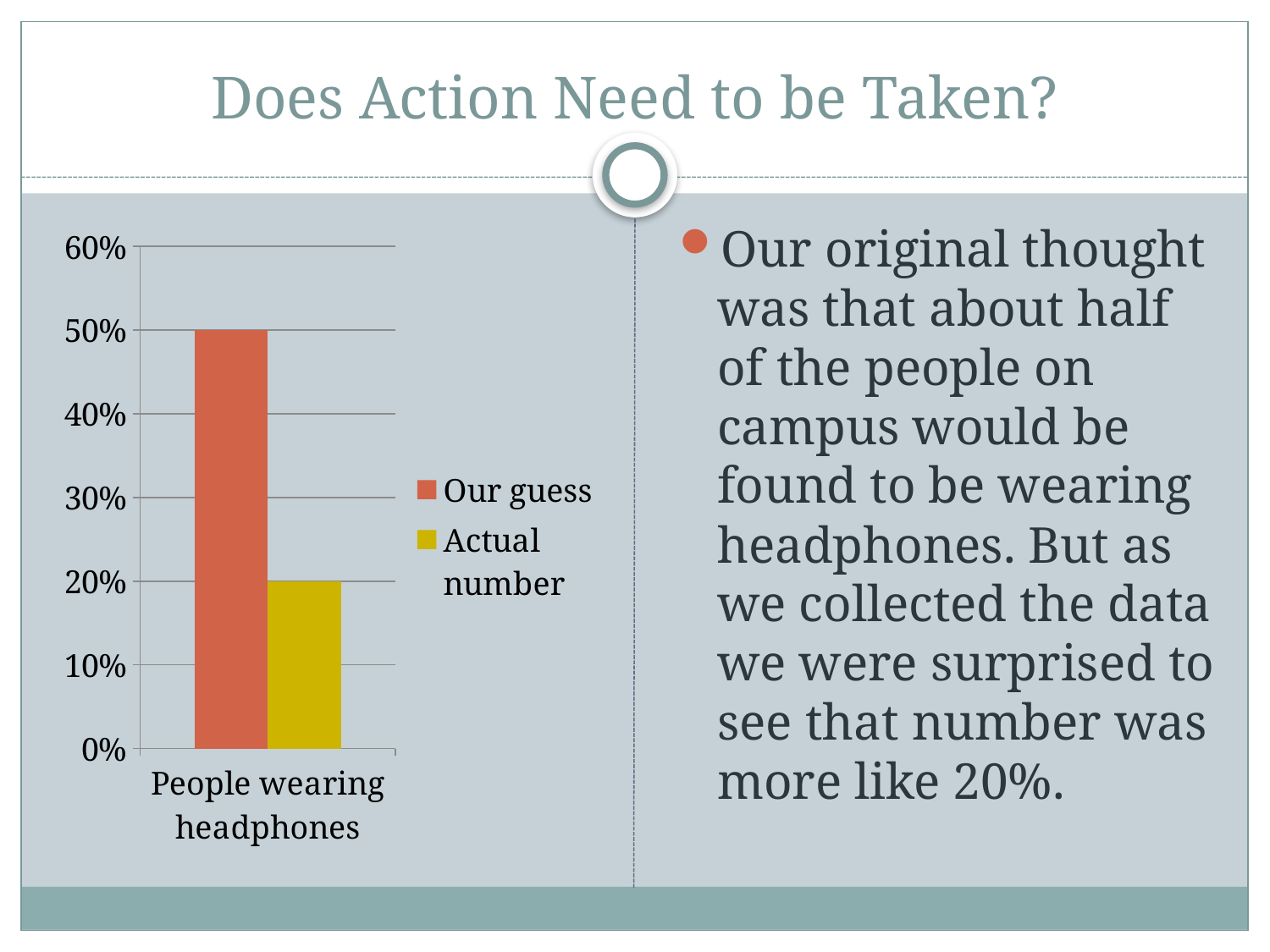
Which series has the higher value for People wearing headphones? Our guess What is the value of the "Actual number" bar for People wearing headphones? 20% Is the value for "Our guess" greater or less than 40%? greater Is the value for "Actual number" greater or less than 30%? less What is the difference between the "Our guess" value and the "Actual number" value? 30% What kind of chart is shown on the slide? bar chart How many series does the chart legend list? 2 What colour is the "Actual number" series in the chart? yellow What is the value of the "Our guess" bar for People wearing headphones? 50% What is the label of the category on the x axis of the chart? People wearing headphones Which series has the lower value for People wearing headphones? Actual number How many categories are shown on the x axis of the chart? 1